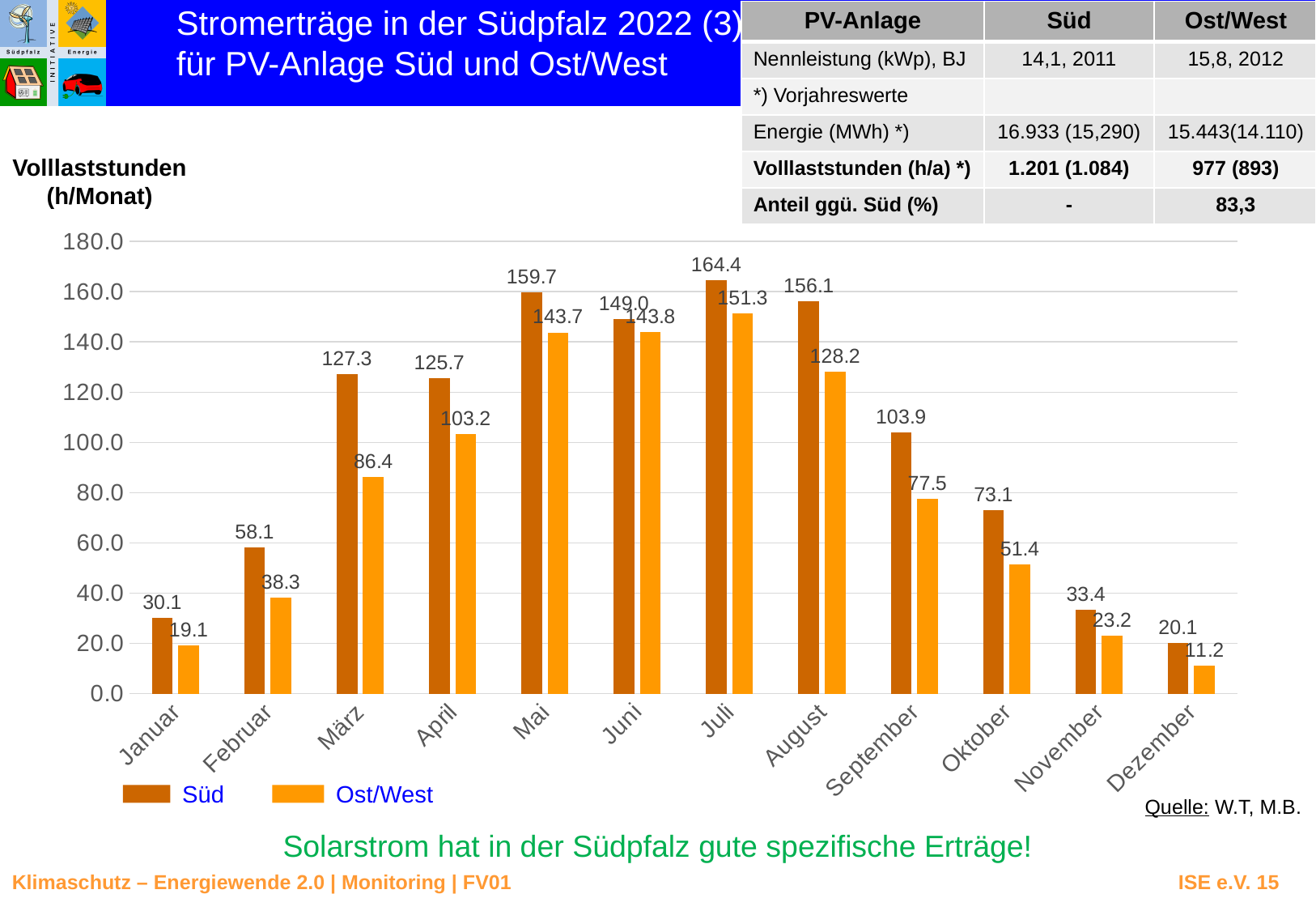
Is the Süd value for August greater or less than 140? greater How many series does the legend list? 2 What is the Süd value for Juli? 164.4 What is the difference between the Süd and Ost/West values for März? 40.9 What kind of chart is shown on the slide? bar chart How many months are shown on the x axis? 12 Which is larger in September, the Süd value or the Ost/West value? Süd Do the Süd values rise or fall from August to Dezember? fall Which month has the highest Süd value? Juli What is the Ost/West value for April? 103.2 What is the Ost/West value for Dezember? 11.2 Which month has the lowest Ost/West value? Dezember